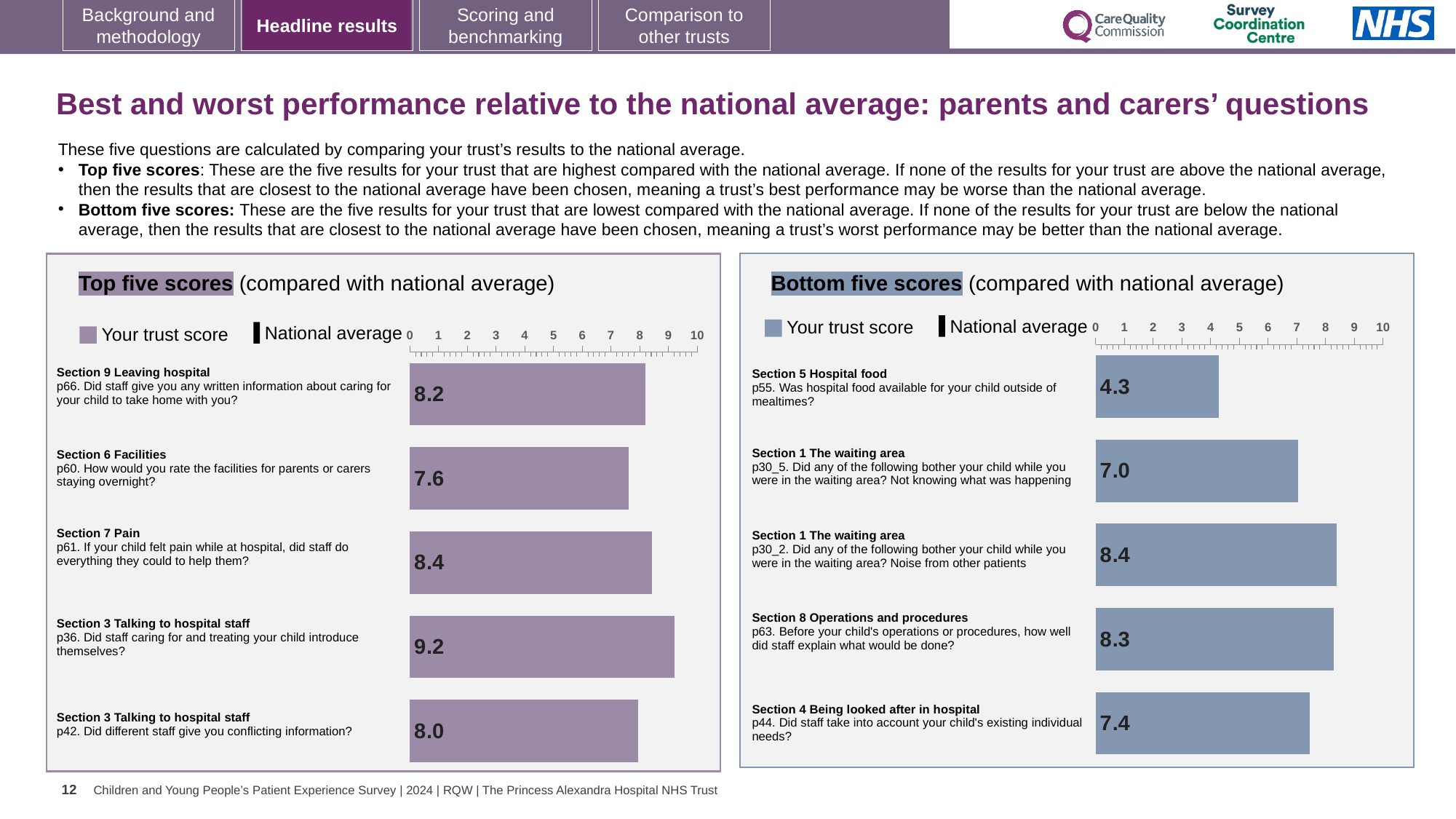
In the Top five scores chart, what is the trust score for p36 (Did staff caring for and treating your child introduce themselves?)? 9.2 In the Bottom five scores chart, which question has the highest trust score? p30_2. Did any of the following bother your child while you were in the waiting area? Noise from other patients In the Bottom five scores chart, what is the difference between the trust scores for p30_2 and p55? 4.1 In the Bottom five scores chart, what is the trust score for p55 (Was hospital food available for your child outside of mealtimes?)? 4.3 In the Top five scores chart, what is the trust score for p42 (Did different staff give you conflicting information?)? 8.0 In the Top five scores chart, which question has the highest trust score? p36. Did staff caring for and treating your child introduce themselves? In the Top five scores chart, what is the difference between the trust scores for p36 and p60? 1.6 How many entries does the legend of the Top five scores chart list? 2 How many questions are plotted in the Top five scores chart? 5 What type of chart is the Bottom five scores chart? Bar chart In the Bottom five scores chart, which has the larger trust score: p30_2 (Noise from other patients) or p63 (how well did staff explain what would be done)? p30_2 In the Bottom five scores chart, which question has the lowest trust score? p55. Was hospital food available for your child outside of mealtimes?